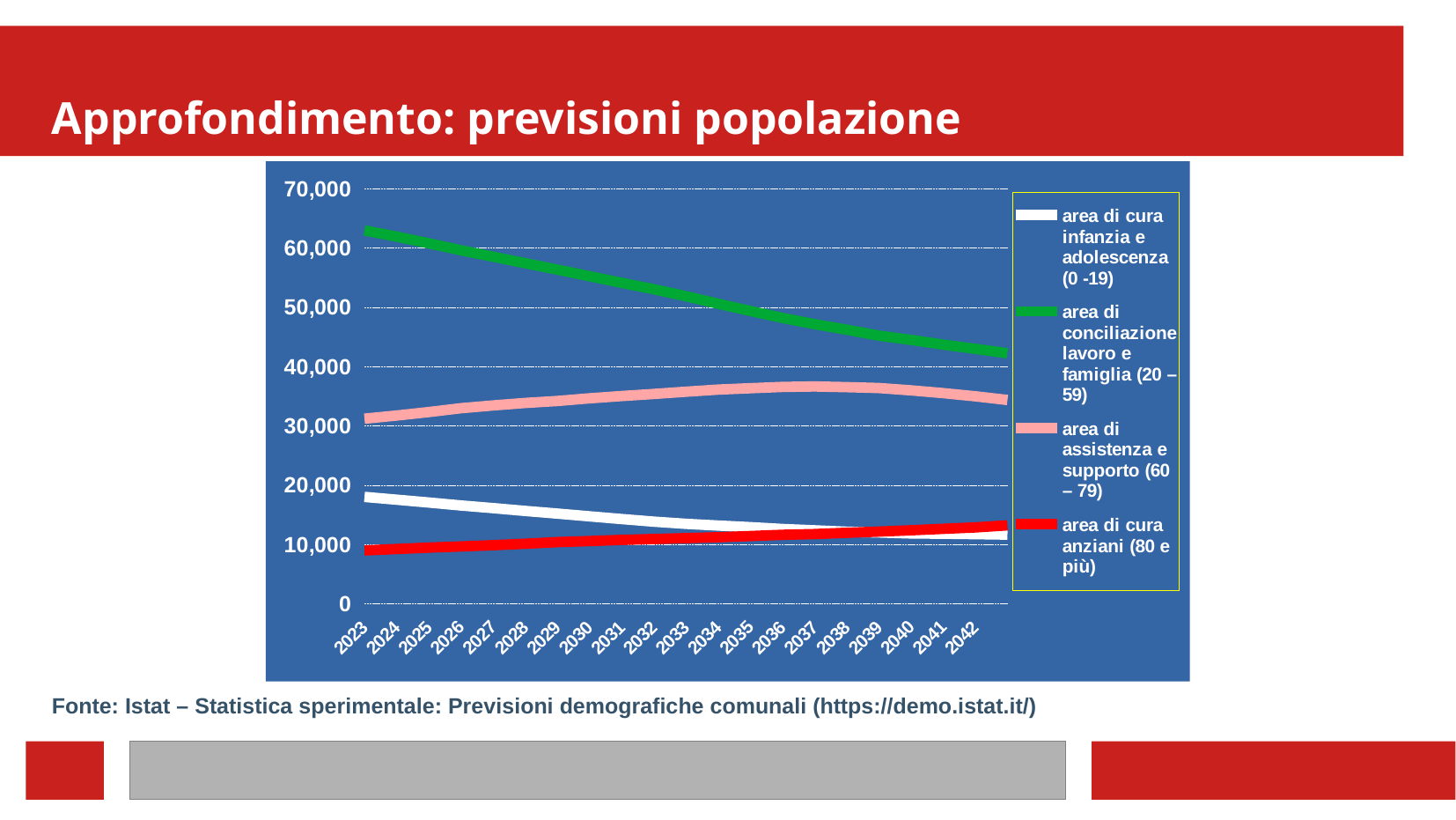
Is the value for 'area di cura infanzia e adolescenza (0 -19)' in 2023 greater or less than 20,000? less What colour is the line for 'area di cura anziani (80 e più)'? red What kind of chart is shown on the slide? line chart Is the value for 'area di assistenza e supporto (60 – 79)' in 2037 greater or less than 40,000? less How many series does the legend list? 4 Does the value for 'area di cura anziani (80 e più)' rise or fall from 2023 to 2042? rise Is the value for 'area di conciliazione lavoro e famiglia (20 – 59)' in 2023 greater or less than 60,000? greater How many years are shown along the x axis? 20 Which series has the highest value in 2023? area di conciliazione lavoro e famiglia (20 – 59) Does the value for 'area di conciliazione lavoro e famiglia (20 – 59)' rise or fall from 2023 to 2042? fall Which series has the lowest value in 2023? area di cura anziani (80 e più) In 2042, which is larger: the value for 'area di conciliazione lavoro e famiglia (20 – 59)' or the value for 'area di assistenza e supporto (60 – 79)'? area di conciliazione lavoro e famiglia (20 – 59)